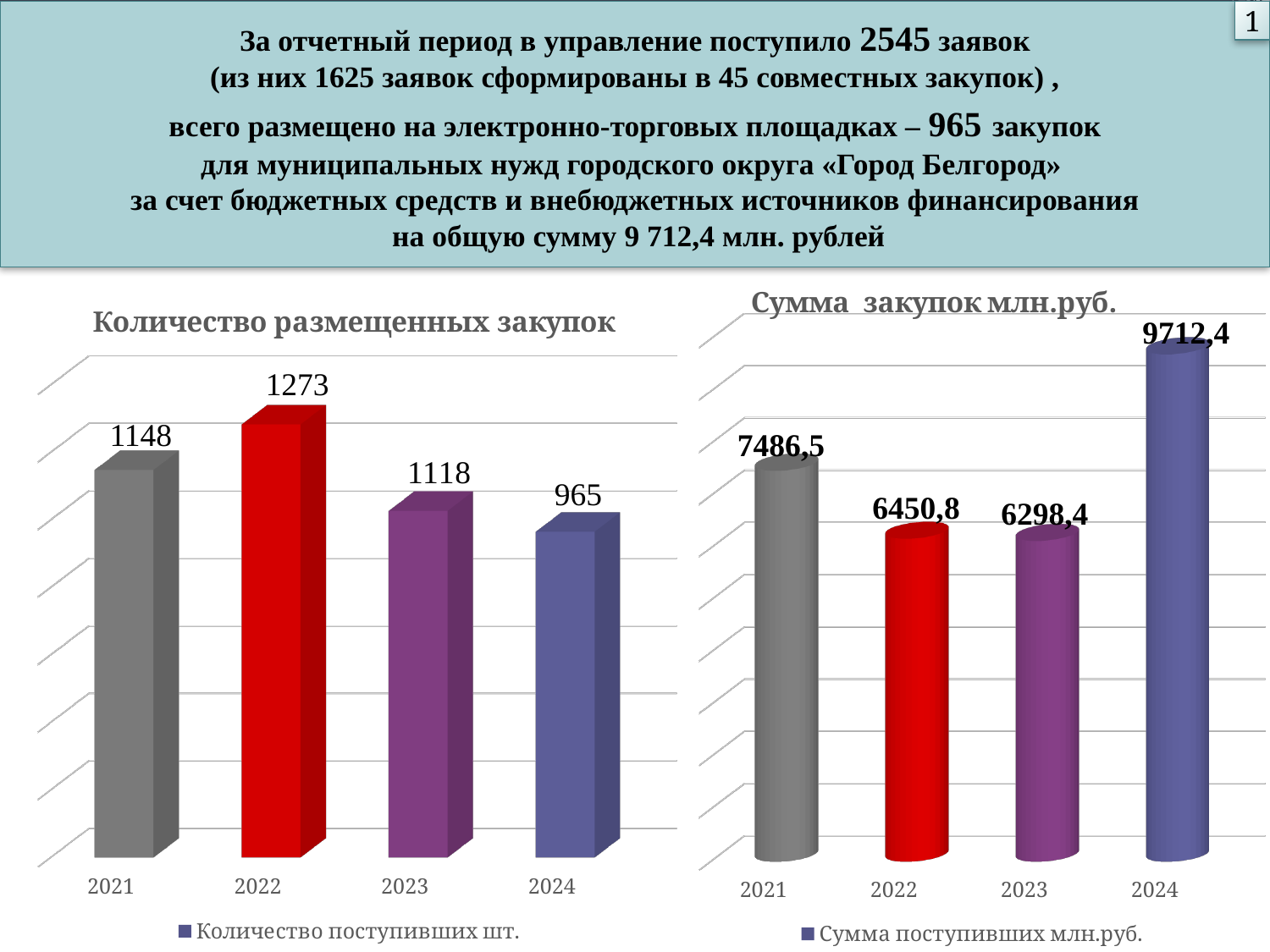
In the chart 'Сумма закупок млн.руб.', what is the value for 2021? 7486,5 What is the legend entry of the chart 'Количество размещенных закупок'? Количество поступивших шт. In the chart 'Количество размещенных закупок', what is the difference between the values for 2022 and 2024? 308 In the chart 'Количество размещенных закупок', how many years are shown on the x axis? 4 In the chart 'Сумма закупок млн.руб.', which year has the lowest value? 2023 In the chart 'Количество размещенных закупок', which year has the lowest value? 2024 In the chart 'Количество размещенных закупок', which year has the highest value? 2022 In the chart 'Сумма закупок млн.руб.', what is the difference between the values for 2024 and 2021? 2225,9 What kind of chart is the chart 'Сумма закупок млн.руб.'? Bar chart In the chart 'Сумма закупок млн.руб.', is the value for 2021 larger or the value for 2022? 2021 In the chart 'Количество размещенных закупок', what is the value for 2022? 1273 In the chart 'Сумма закупок млн.руб.', which year has the highest value? 2024